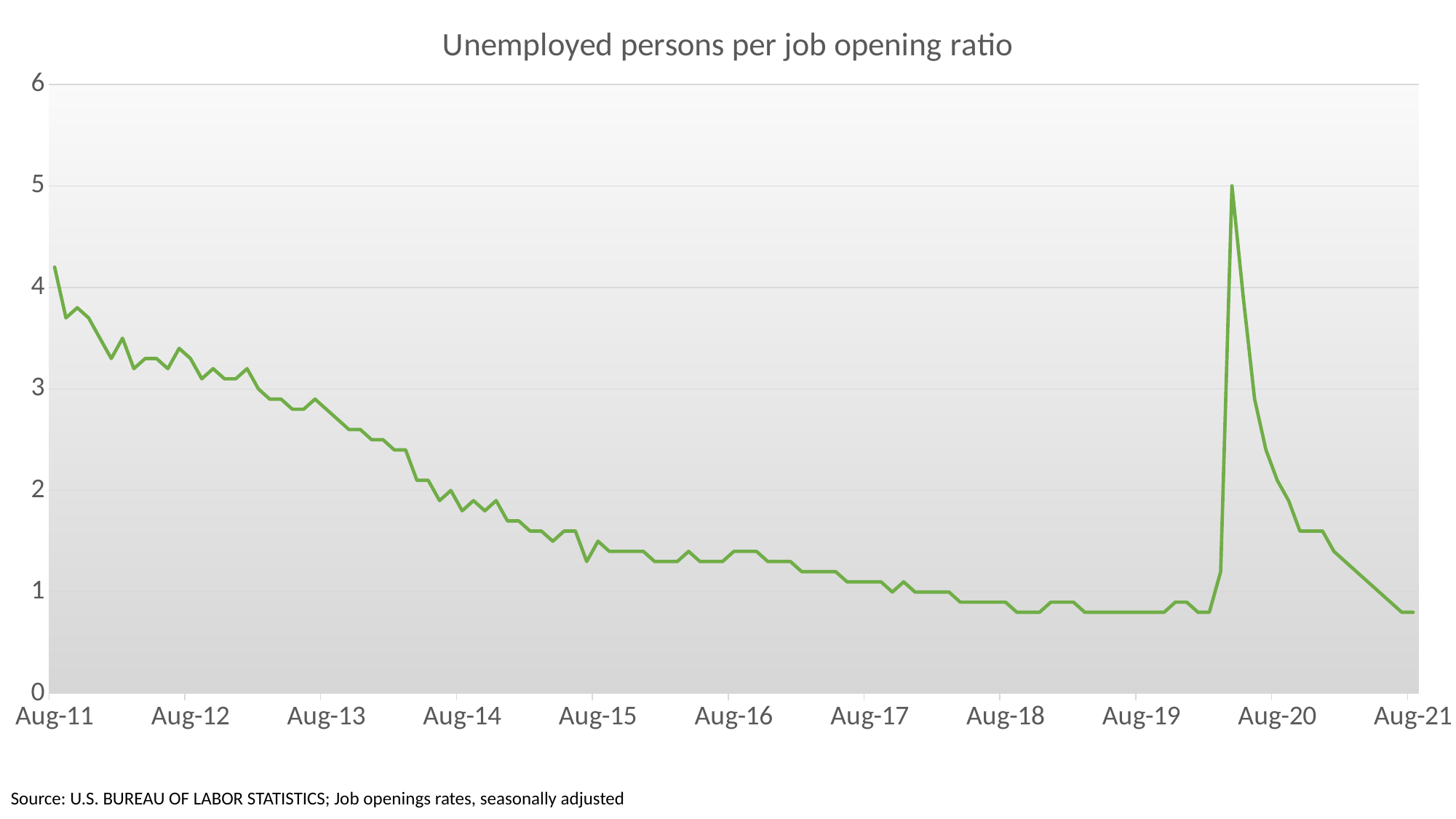
What source is cited below the chart? U.S. BUREAU OF LABOR STATISTICS; Job openings rates, seasonally adjusted Is the value at Aug-21 greater or less than 1? less What type of chart is shown on the slide? line chart Does the line generally rise or fall from Aug-11 to Aug-19? fall Which is larger, the value at Aug-12 or the value at Aug-18? Aug-12 Is the value at Aug-11 greater or less than 4? greater Is the value at Aug-16 greater or less than 2? less What is the title of the chart? Unemployed persons per job opening ratio Which is larger, the value at Aug-11 or the value at Aug-21? Aug-11 How many lines are plotted on the chart? 1